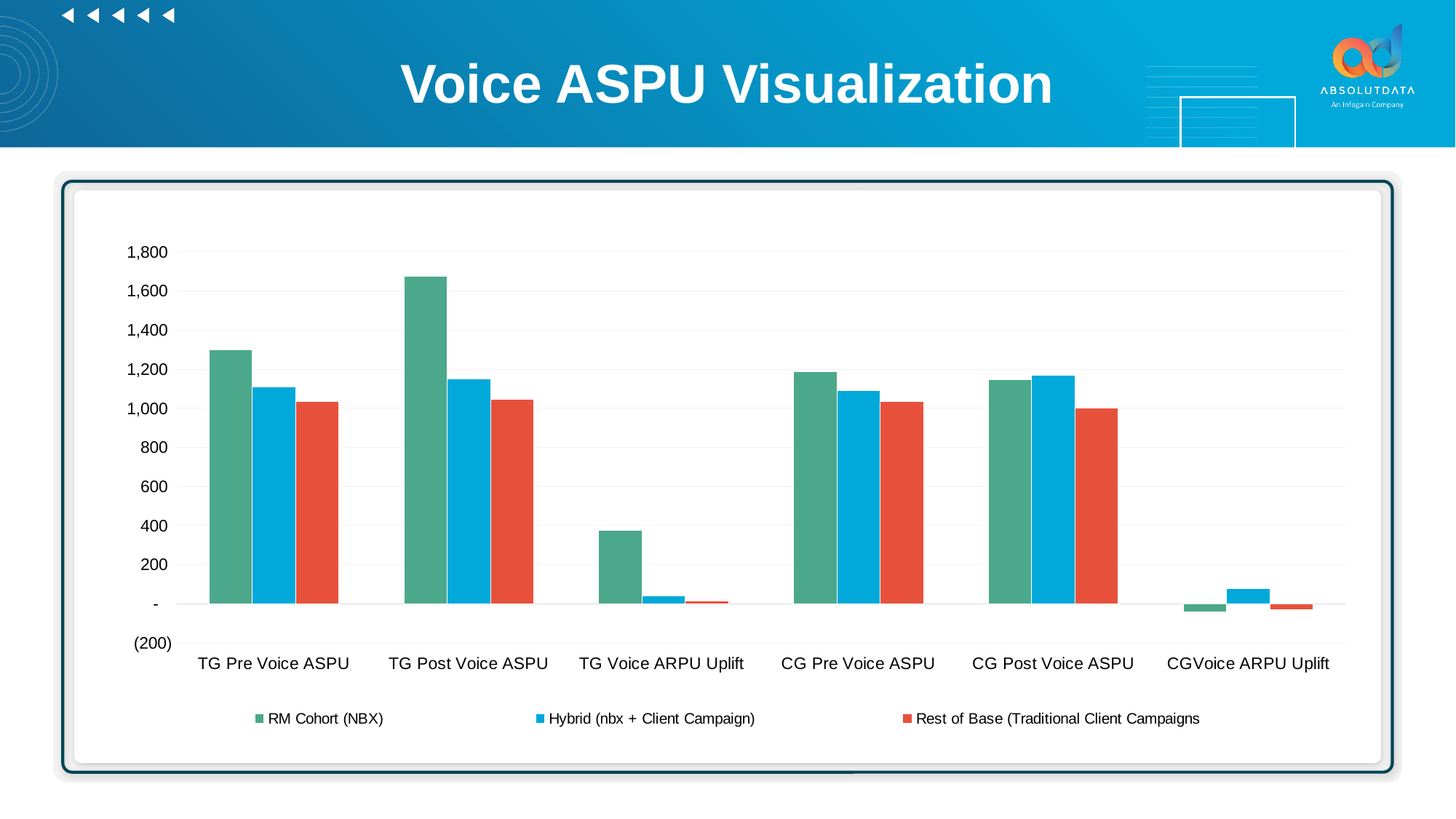
What kind of chart is shown on the slide? Bar chart Is the RM Cohort (NBX) value for TG Voice ARPU Uplift greater or less than 200? greater For TG Voice ARPU Uplift, which series has the lowest value? Rest of Base (Traditional Client Campaigns) Is the RM Cohort (NBX) value for TG Post Voice ASPU greater or less than 1,600? greater What is the title of the slide containing the chart? Voice ASPU Visualization Is the Rest of Base (Traditional Client Campaigns) value for TG Pre Voice ASPU greater or less than 1,200? less For TG Pre Voice ASPU, which is larger: the RM Cohort (NBX) value or the Hybrid (nbx + Client Campaign) value? RM Cohort (NBX) How many categories are shown along the x axis? 6 How many series does the legend list? 3 For CGVoice ARPU Uplift, which series has the highest value? Hybrid (nbx + Client Campaign) For CG Post Voice ASPU, which is larger: the Hybrid (nbx + Client Campaign) value or the Rest of Base (Traditional Client Campaigns) value? Hybrid (nbx + Client Campaign) For which category is the RM Cohort (NBX) bar the highest? TG Post Voice ASPU